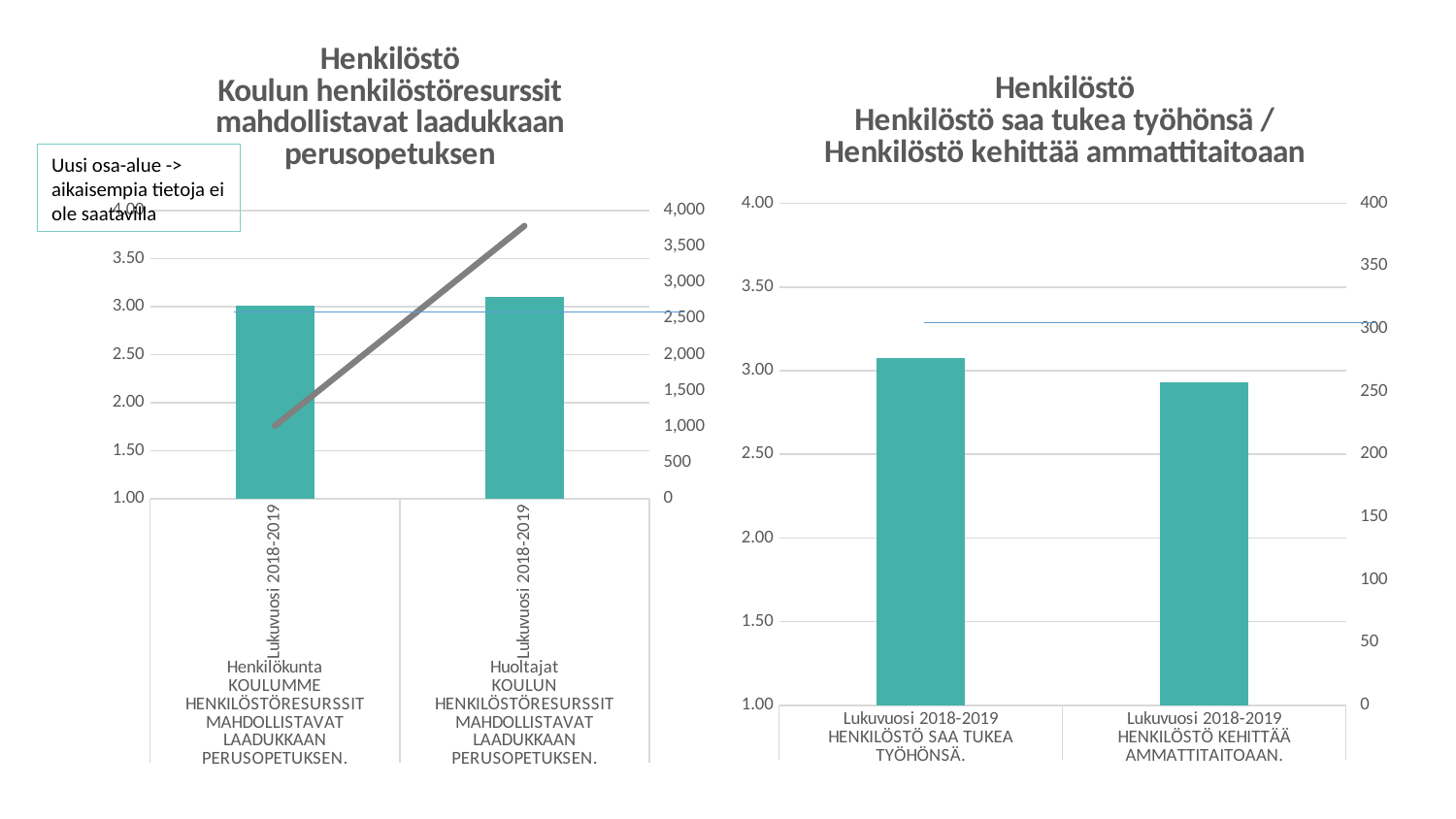
In the right chart (Henkilöstö saa tukea työhönsä / Henkilöstö kehittää ammattitaitoaan), how many bars are plotted? 2 In the left chart, is the value for Henkilökunta greater or less than 2.50? greater What kind of chart is the right chart? combination bar and line chart In the right chart, do the bar values rise or fall from left to right? fall Which school year (lukuvuosi) is shown on the category labels of both charts? Lukuvuosi 2018-2019 In the right chart, which bar is taller: 'Henkilöstö saa tukea työhönsä' or 'Henkilöstö kehittää ammattitaitoaan'? Henkilöstö saa tukea työhönsä In the left chart, what is the maximum value shown on the right-hand axis? 4,000 In the right chart, is the value for 'Henkilöstö kehittää ammattitaitoaan' greater or less than 3.00? less In the left chart, is the value for Huoltajat greater or less than 2.00? greater In the left chart (Koulun henkilöstöresurssit mahdollistavat laadukkaan perusopetuksen), how many bars are plotted? 2 In the left chart, does the grey line rise or fall from left to right? rises